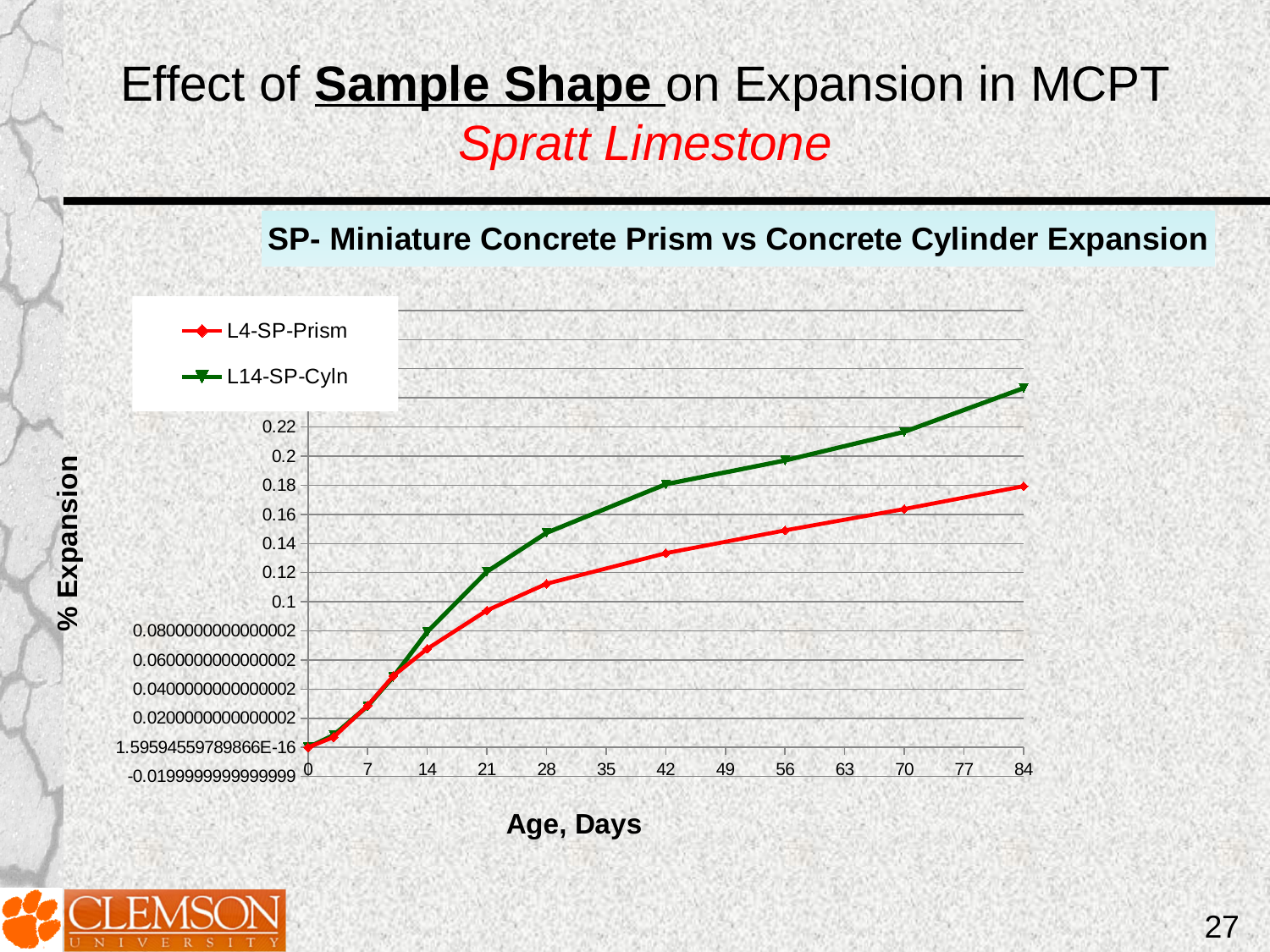
Is the value for L14-SP-Cyln at 70 days greater or less than 0.2? greater What kind of chart is shown on the slide? line chart Which series has the higher value at 42 days? L14-SP-Cyln Is the value for L4-SP-Prism at 84 days greater or less than 0.2? less Which series has the higher value at 84 days? L14-SP-Cyln Do the values for L4-SP-Prism rise or fall as age increases from 0 to 84 days? rise What is the title of the chart? SP- Miniature Concrete Prism vs Concrete Cylinder Expansion How many series does the legend list? 2 Is the value for L14-SP-Cyln at 84 days greater or less than 0.22? greater What are the names of the two series in the legend? L4-SP-Prism and L14-SP-Cyln